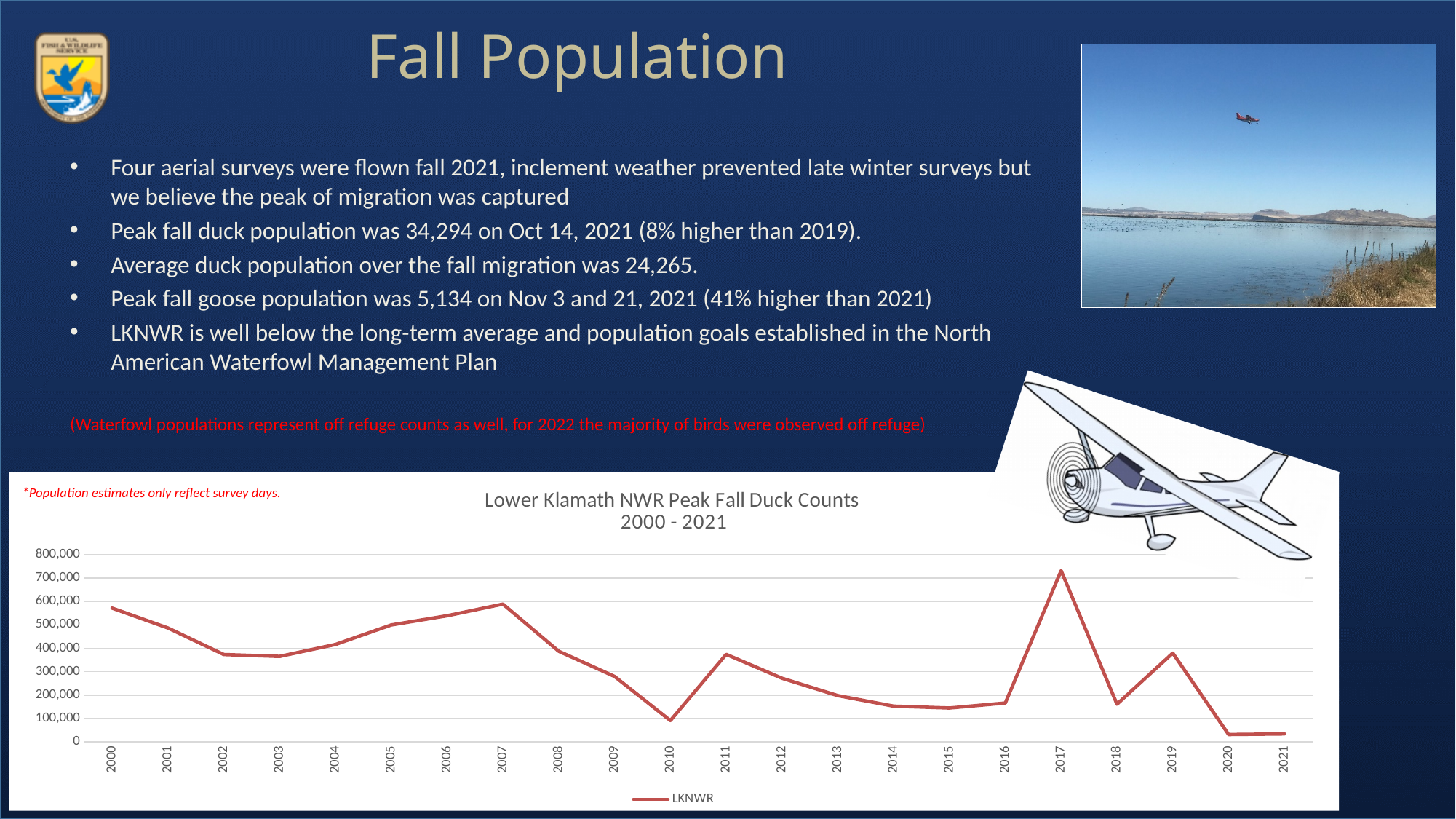
In which year is the peak fall duck count highest? 2017 Do the values rise or fall from 2003 to 2007? rise What is the title of the chart? Lower Klamath NWR Peak Fall Duck Counts 2000 - 2021 How many years are plotted along the x axis of the chart? 22 What kind of chart is shown on the slide? line chart How many series does the chart legend list? 1 What is the name of the series shown in the chart legend? LKNWR Is the value for 2000 greater or less than 500,000? greater Is the value for 2014 greater or less than 200,000? less Is the value for 2017 greater or less than 700,000? greater Which year has the larger peak fall duck count, 2007 or 2008? 2007